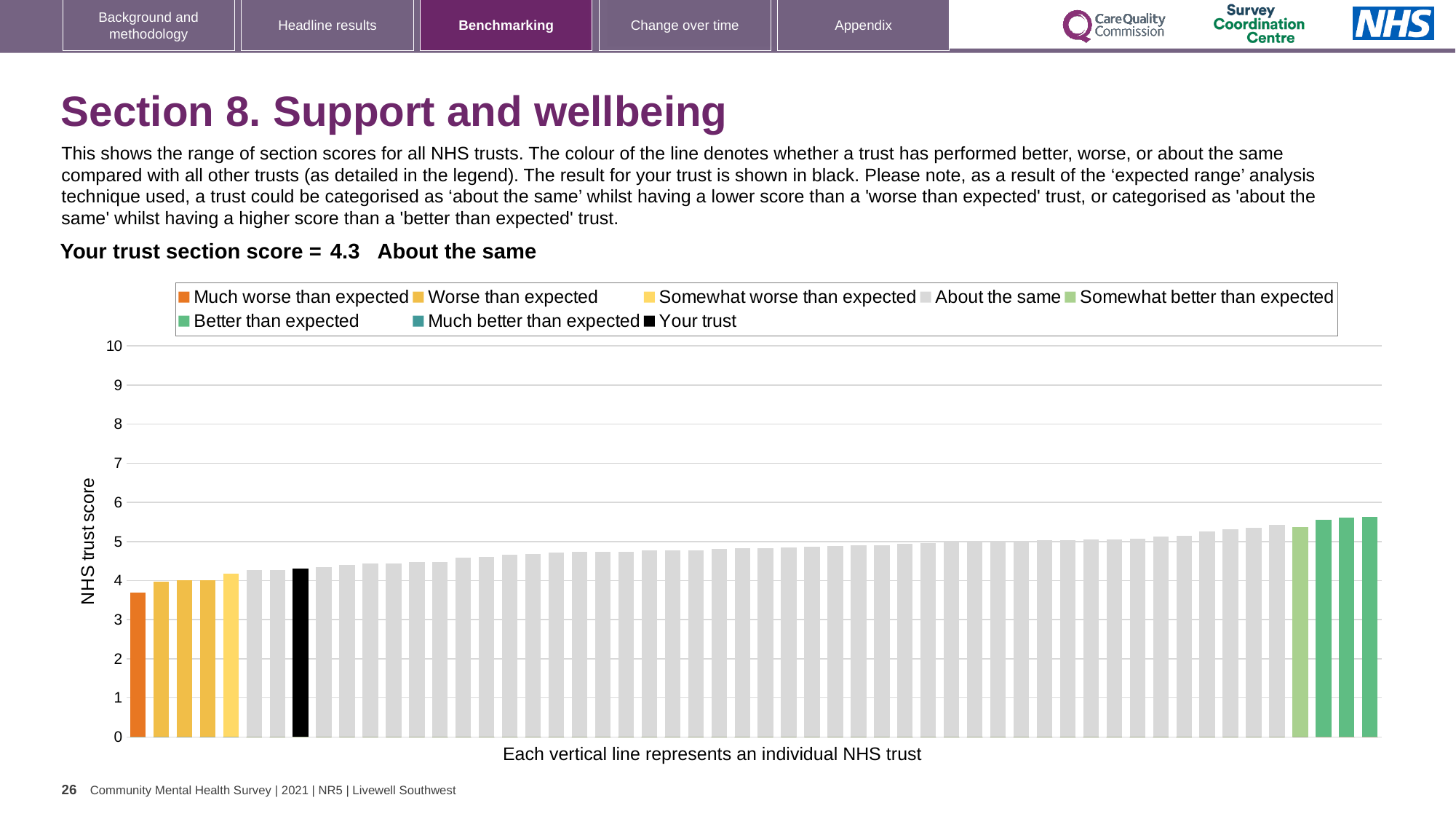
Do the bar values rise or fall from left to right along the x axis? rise How many entries does the chart legend list? 8 What kind of chart is shown on the slide? bar chart Is the value of the orange 'Much worse than expected' bar greater or less than 4? less What is the section score for your trust shown on the slide? 4.3 Is the value of the tallest bar in the chart greater or less than 5? greater Is the value of the black 'Your trust' bar greater or less than 5? less Which legend category does the lowest bar in the chart belong to? Much worse than expected What is the label on the vertical axis of the chart? NHS trust score Which benchmarking category is your trust placed in for this section? About the same How many bars are coloured as 'Better than expected' (dark green)? 3 How many bars are coloured orange ('Much worse than expected')? 1